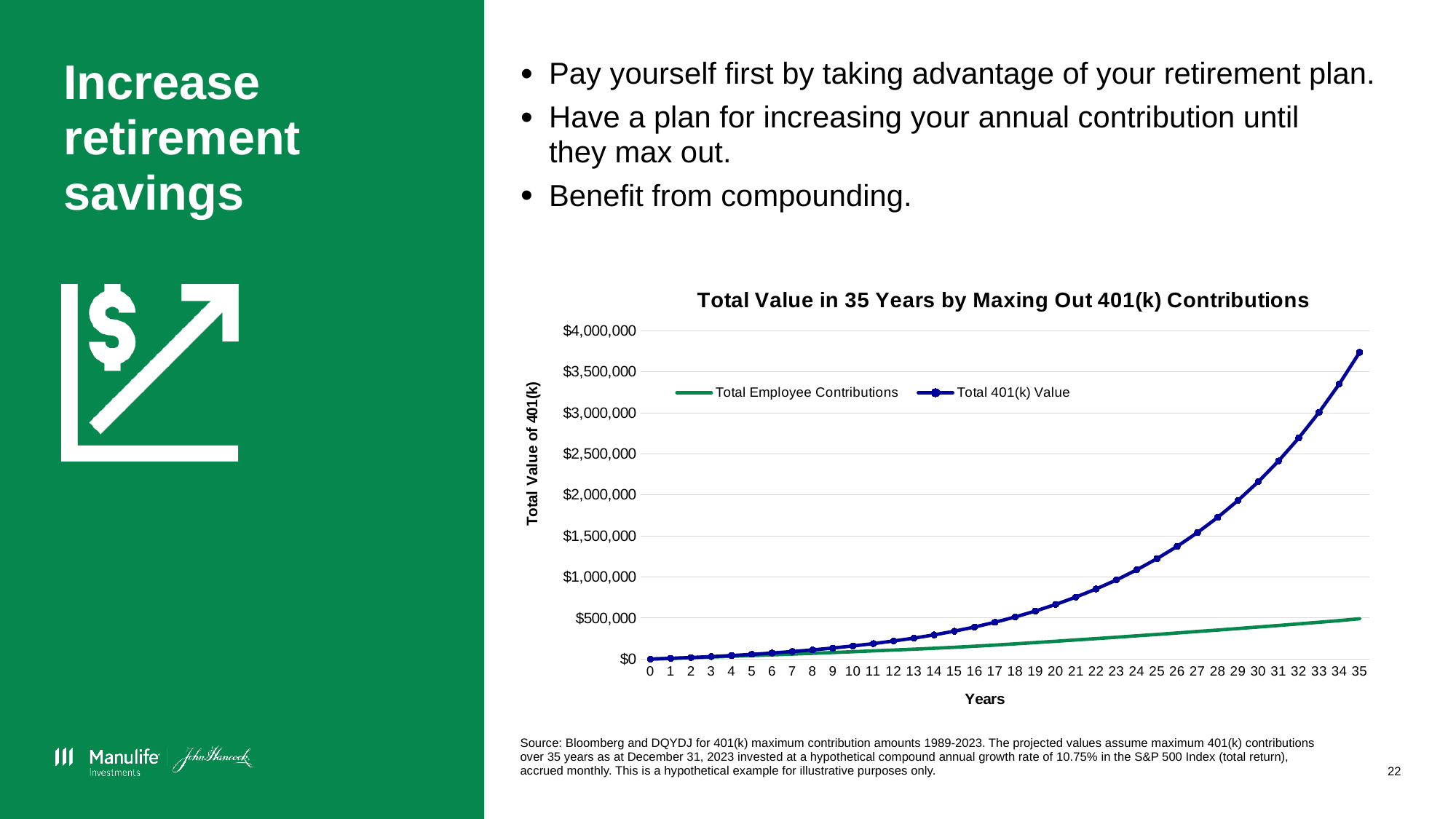
Does the Total 401(k) Value series rise or fall as the years increase? rise Is the Total 401(k) Value at year 35 greater or less than $3,500,000? greater Is the Total 401(k) Value at year 25 greater or less than $1,000,000? greater Is the Total 401(k) Value at year 10 greater or less than $500,000? less What is the title of the chart? Total Value in 35 Years by Maxing Out 401(k) Contributions At year 35, which series is larger: Total Employee Contributions or Total 401(k) Value? Total 401(k) Value What is the label on the vertical axis of the chart? Total Value of 401(k) At which year does the Total 401(k) Value series reach its highest point? 35 How many series does the chart legend list? 2 How many years are shown along the x axis of the chart, from 0 to 35 inclusive? 36 What type of chart is shown on the slide? line chart